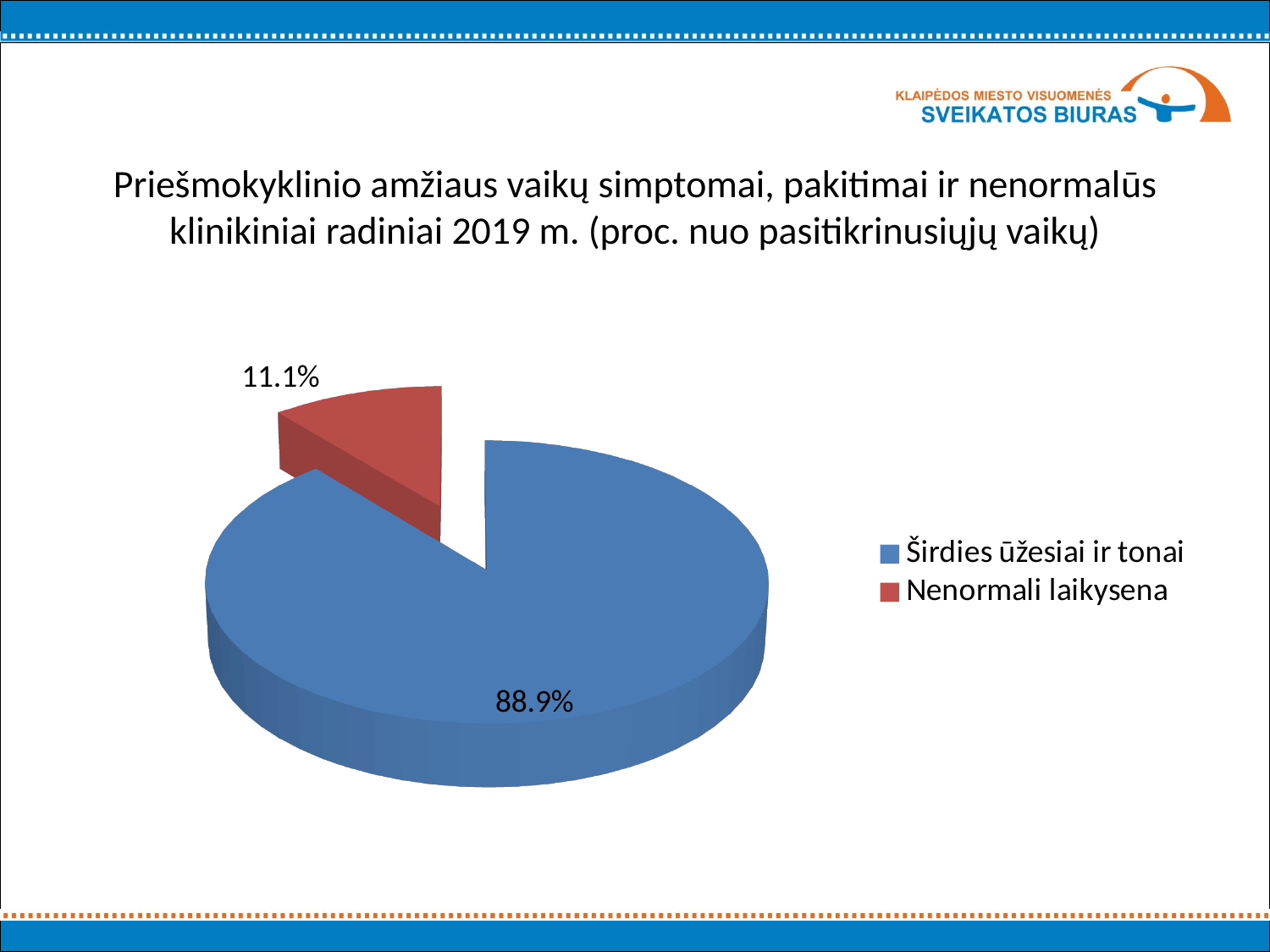
Which is larger, the value for Širdies ūžesiai ir tonai or the value for Nenormali laikysena? Širdies ūžesiai ir tonai What share of the pie does the Nenormali laikysena slice represent? 11.1% What is the difference between the values for Širdies ūžesiai ir tonai and Nenormali laikysena? 77.8% How many slices does the pie chart have? 2 Which category has the smallest share of the pie? Nenormali laikysena What kind of chart is shown on the slide? Pie chart What colour is the slice for Širdies ūžesiai ir tonai? Blue What is the value for Širdies ūžesiai ir tonai? 88.9% Which category has the largest share of the pie? Širdies ūžesiai ir tonai What is the value for Nenormali laikysena? 11.1% How many entries does the legend list? 2 What colour is the slice for Nenormali laikysena? Red